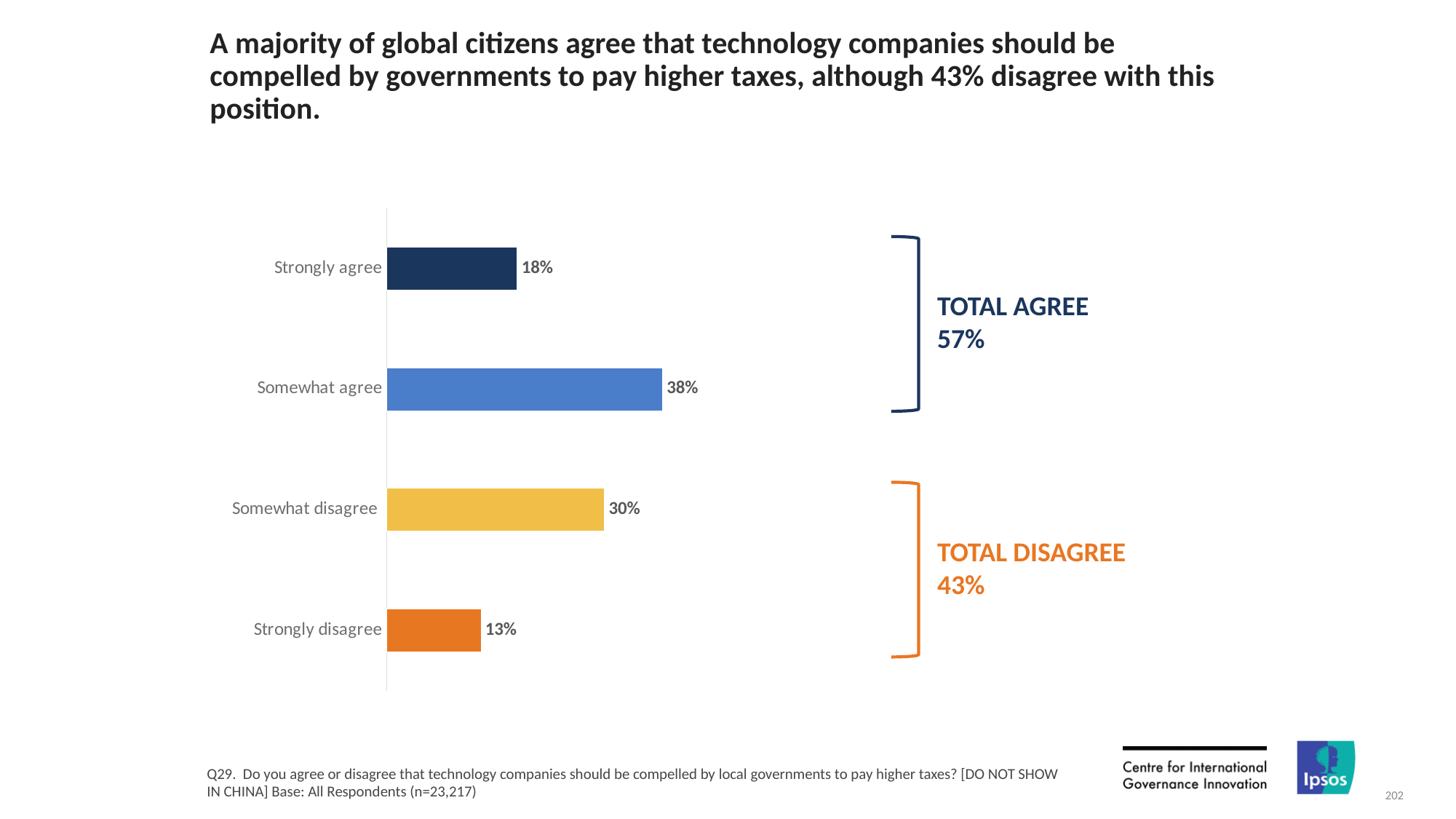
What is the value for Strongly disagree? 13% What is the value for Somewhat agree? 38% How many categories are shown in the chart? 4 What is the value for Strongly agree? 18% What is the Total Agree percentage shown on the slide? 57% What is the value for Somewhat disagree? 30% Which category has the lowest value? Strongly disagree Which category has the highest value? Somewhat agree What kind of chart is shown on the slide? Bar chart What is the Total Disagree percentage shown on the slide? 43% What is the difference between Somewhat agree and Somewhat disagree? 8% Which is larger, Strongly agree or Strongly disagree? Strongly agree